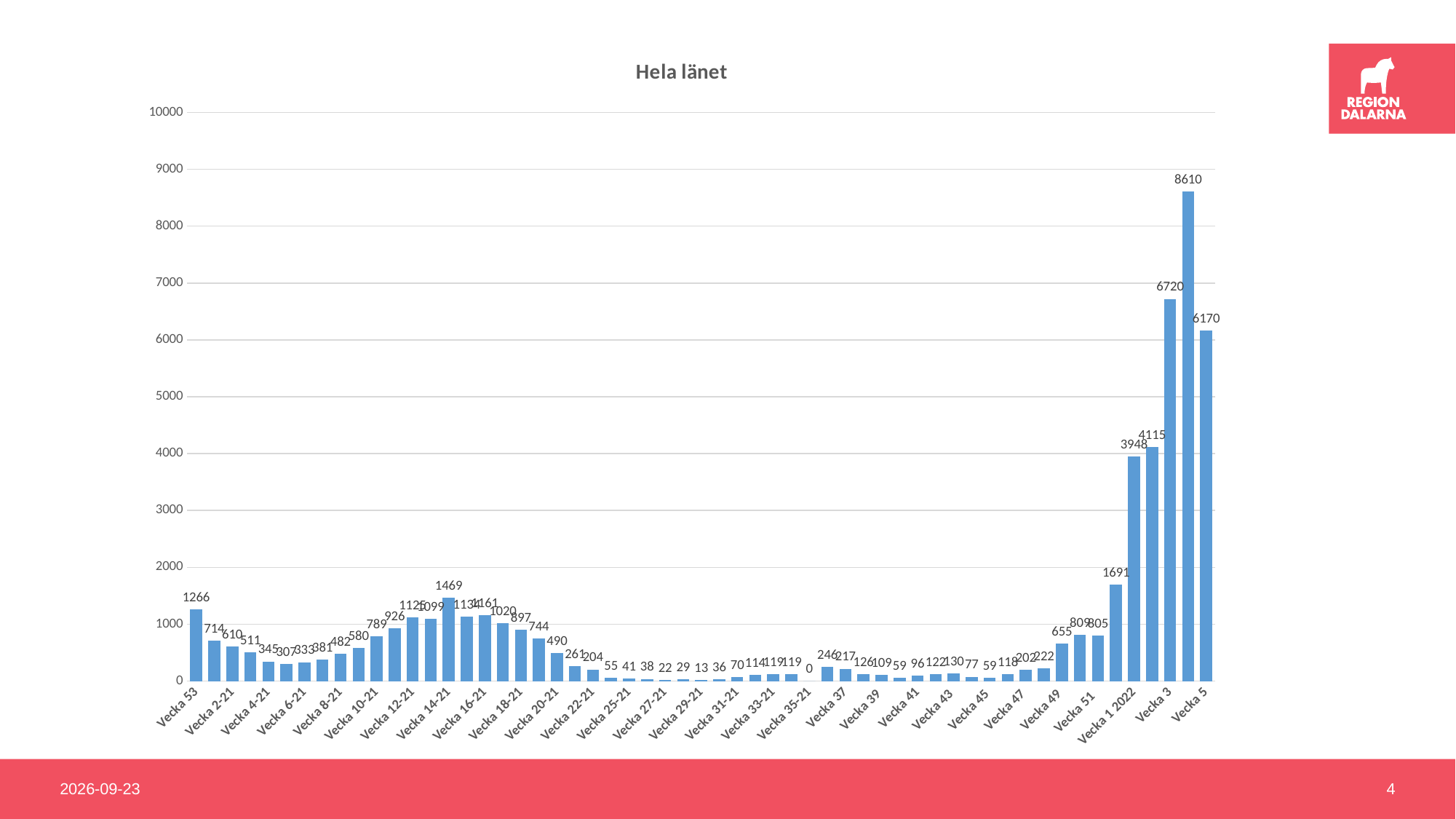
Which is larger, the value for Vecka 14-21 or the value for Vecka 1 2022? Vecka 1 2022 What is the highest value shown in the chart? 8610 What is the value for Vecka 5? 6170 What is the value for Vecka 14-21? 1469 What is the title of the chart? Hela länet Do the values rise or fall from Vecka 49 to Vecka 3? rise What type of chart is shown on the slide? Bar chart Which labelled week has the lowest value? Vecka 35-21 What is the value for Vecka 53? 1266 Is the value for Vecka 49 greater or less than 1000? less What is the difference between the values for Vecka 3 and Vecka 5? 550 What is the value for Vecka 1 2022? 3948